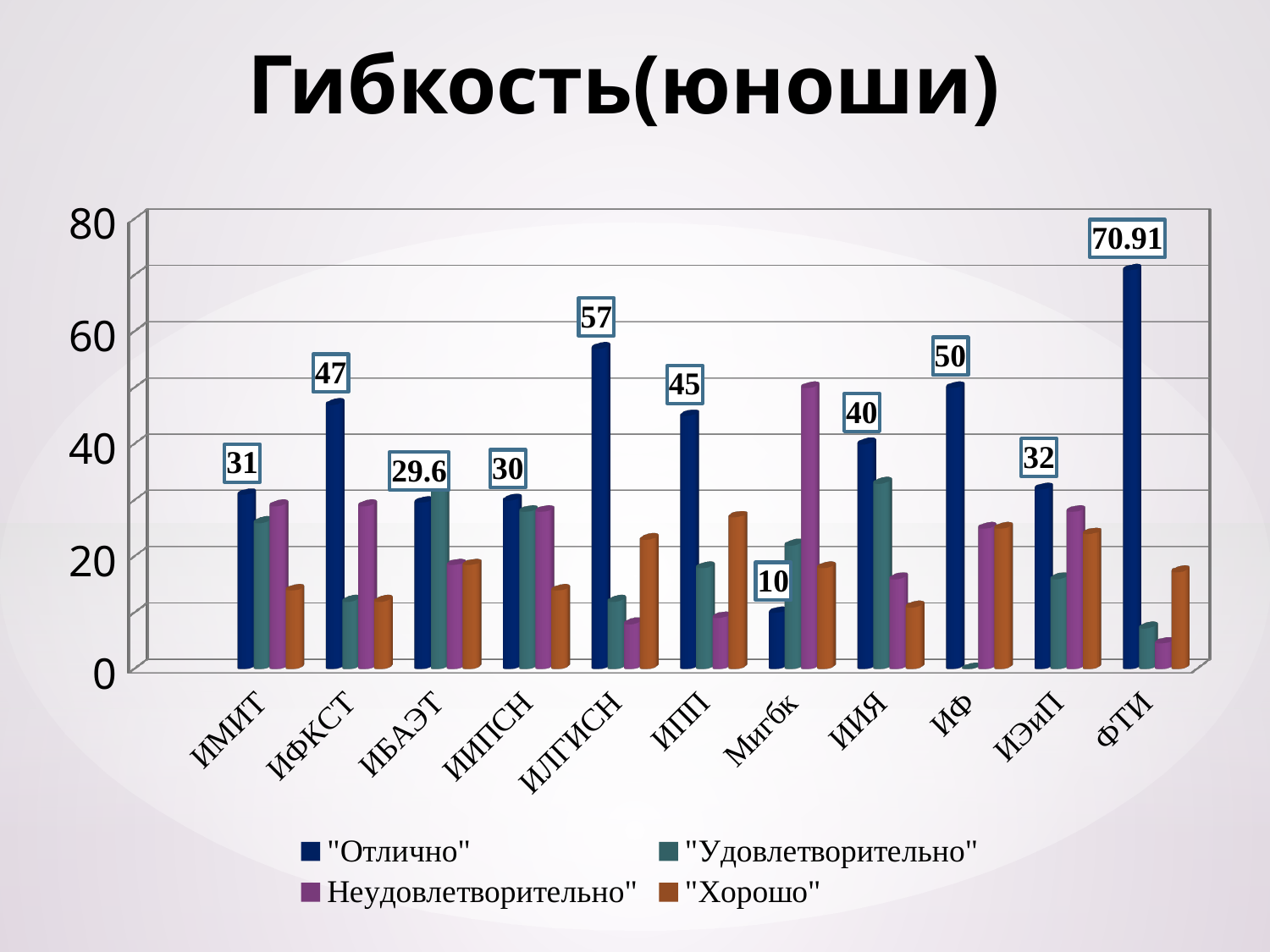
Which category has the lowest value for "Отлично"? Мигбк How many series does the legend list? 4 Which is larger, the "Отлично" value for ИФКСТ or for ИПП? ИФКСТ What is the value for "Отлично" for ИБАЭТ? 29.6 What is the value for "Отлично" for ФТИ? 70.91 What is the difference between the "Отлично" values for ИФ and ИИЯ? 10 Is the value for "Неудовлетворительно" for Мигбк greater or less than 40? greater Which category has the highest value for "Отлично"? ФТИ What kind of chart is shown on the slide? bar chart How many categories are shown on the x axis? 11 What is the value for "Отлично" for ИЛГИСН? 57 Is the value for "Хорошо" for ИМИТ greater or less than 20? less